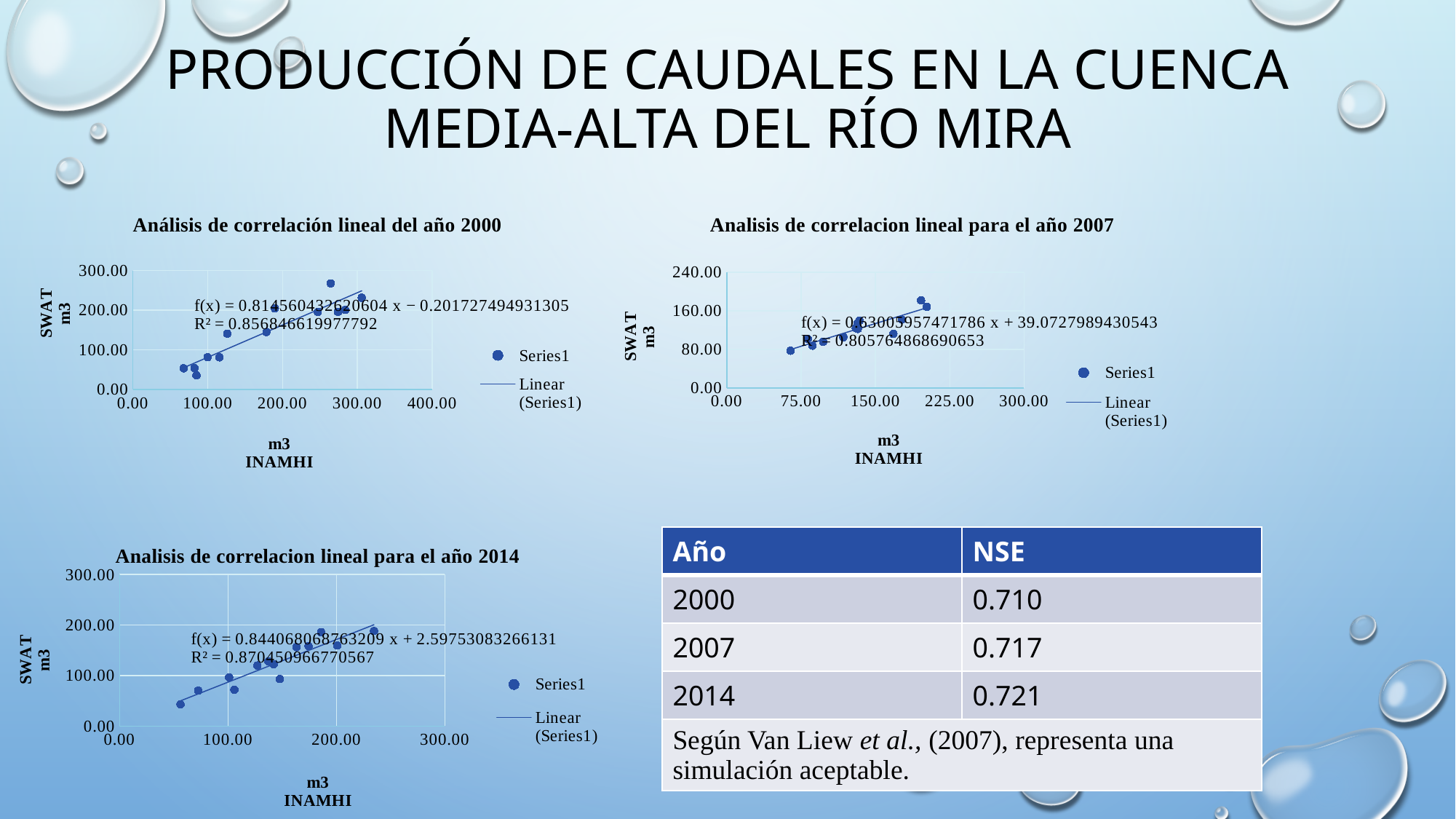
In the 'Analisis de correlacion lineal para el año 2007' chart, do the plotted points generally rise or fall along the x axis? rise What kind of chart is the 'Análisis de correlación lineal del año 2000' chart? scatter chart How many entries does the legend of the 'Analisis de correlacion lineal para el año 2007' chart list? 2 In the 'Analisis de correlacion lineal para el año 2007' chart, is the highest plotted SWAT value greater or less than 160.00? greater What is the maximum value shown on the y axis of the 'Analisis de correlacion lineal para el año 2007' chart? 240.00 In the 'Analisis de correlacion lineal para el año 2014' chart, is the highest plotted SWAT value greater or less than 200.00? less In the 'Análisis de correlación lineal del año 2000' chart, what R² value is printed? R² = 0.856846619977792 In the 'Analisis de correlacion lineal para el año 2014' chart, is the lowest plotted SWAT value greater or less than 100.00? less In the 'Analisis de correlacion lineal para el año 2014' chart, what R² value is printed? R² = 0.870450966770567 In the 'Análisis de correlación lineal del año 2000' chart, do the SWAT values generally rise or fall as the INAMHI values increase along the x axis? rise